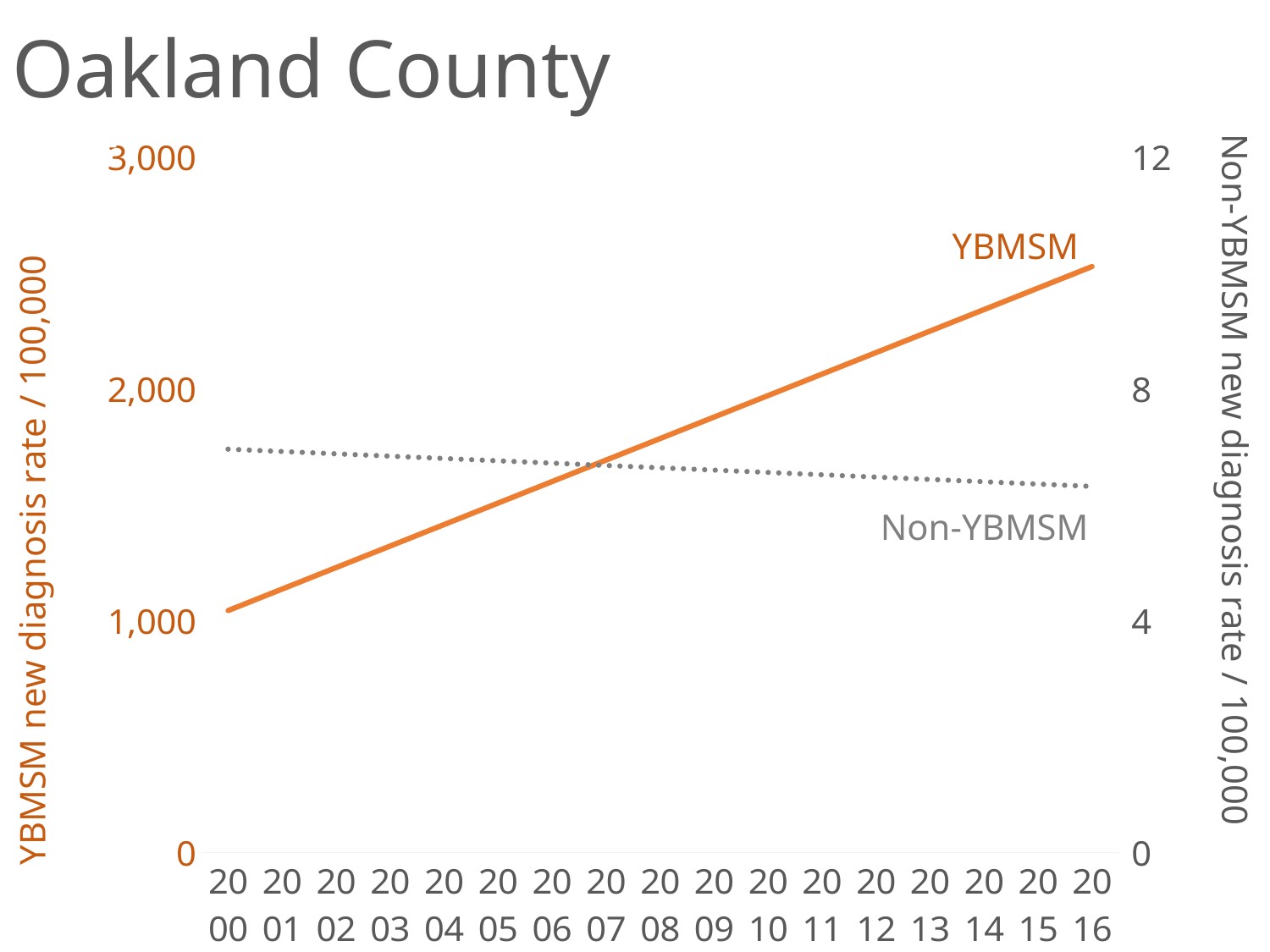
Does the Non-YBMSM line rise or fall from 2000 to 2016? fall How many years are shown along the x axis? 17 Which series is drawn as a dotted line? Non-YBMSM Is the YBMSM value for 2000 greater or less than 2,000? less Is the Non-YBMSM value for 2000 greater or less than 8? less What is the label of the left vertical axis? YBMSM new diagnosis rate / 100,000 What kind of chart is shown on the slide? line chart What is the title of the chart? Oakland County Is the YBMSM value for 2016 greater or less than 2,000? greater Does the YBMSM line rise or fall from 2000 to 2016? rise How many series are plotted on the chart? 2